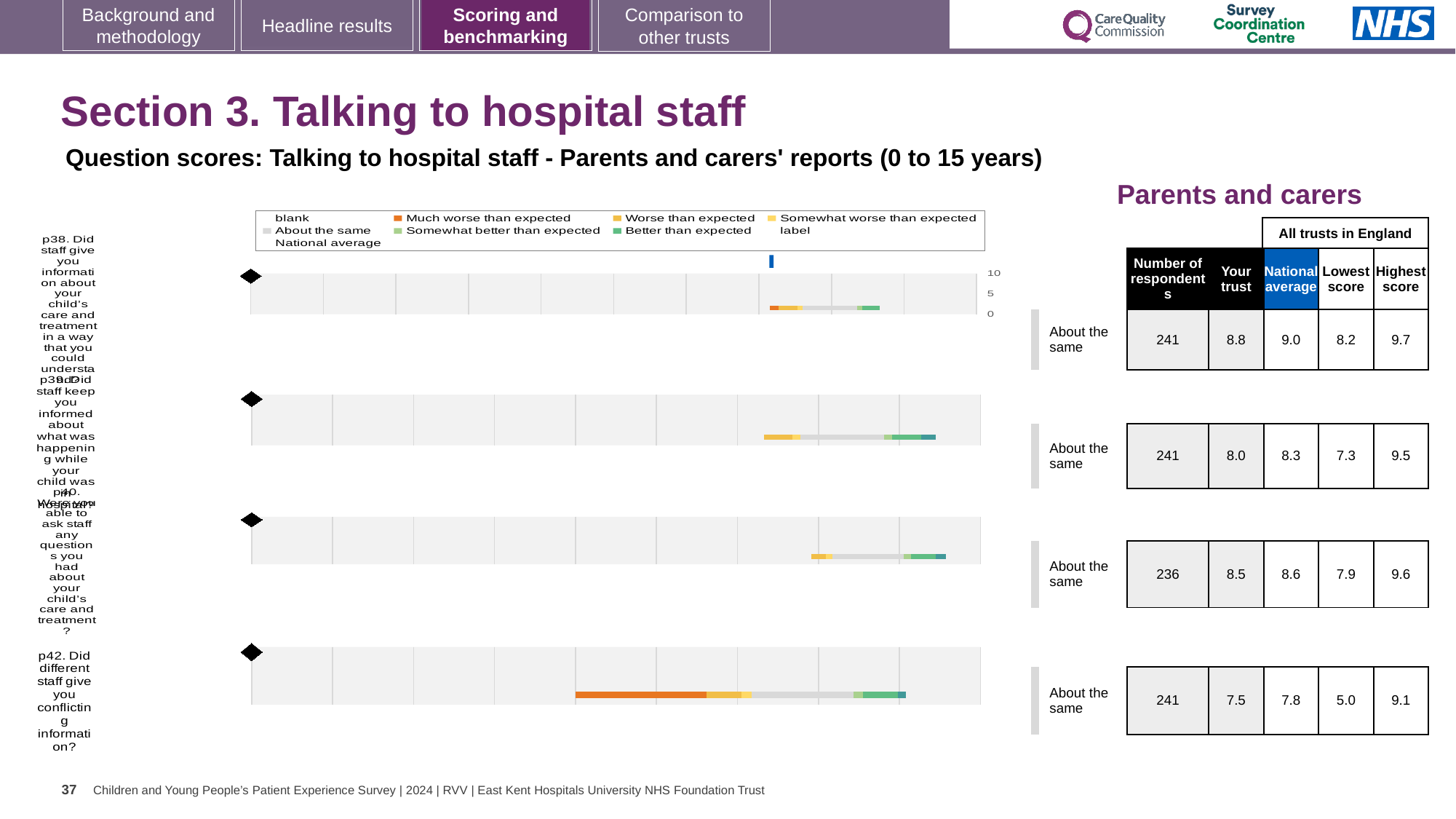
What kind of chart is used for each question on this slide? bar chart For the p38 chart, what is the difference between the Highest score and the Lowest score? 1.5 What benchmark category is shown next to the p42 chart? About the same For the p40 chart, which is larger: the 'Your trust' score or the National average? National average For the p40 chart (able to ask staff questions), how many respondents are listed? 236 Which question has the highest 'Your trust' score? p38 Which question has the lowest 'Your trust' score? p42 How many question charts are shown on the slide? 4 For the p42 chart (conflicting information), what is the Highest score among all trusts in England? 9.1 For the p38 chart (staff giving information about your child's care), what is the 'Your trust' score in the table? 8.8 For the p39 chart (staff keeping you informed), what is the National average score? 8.3 For the p42 chart (conflicting information), what is the Lowest score among all trusts in England? 5.0